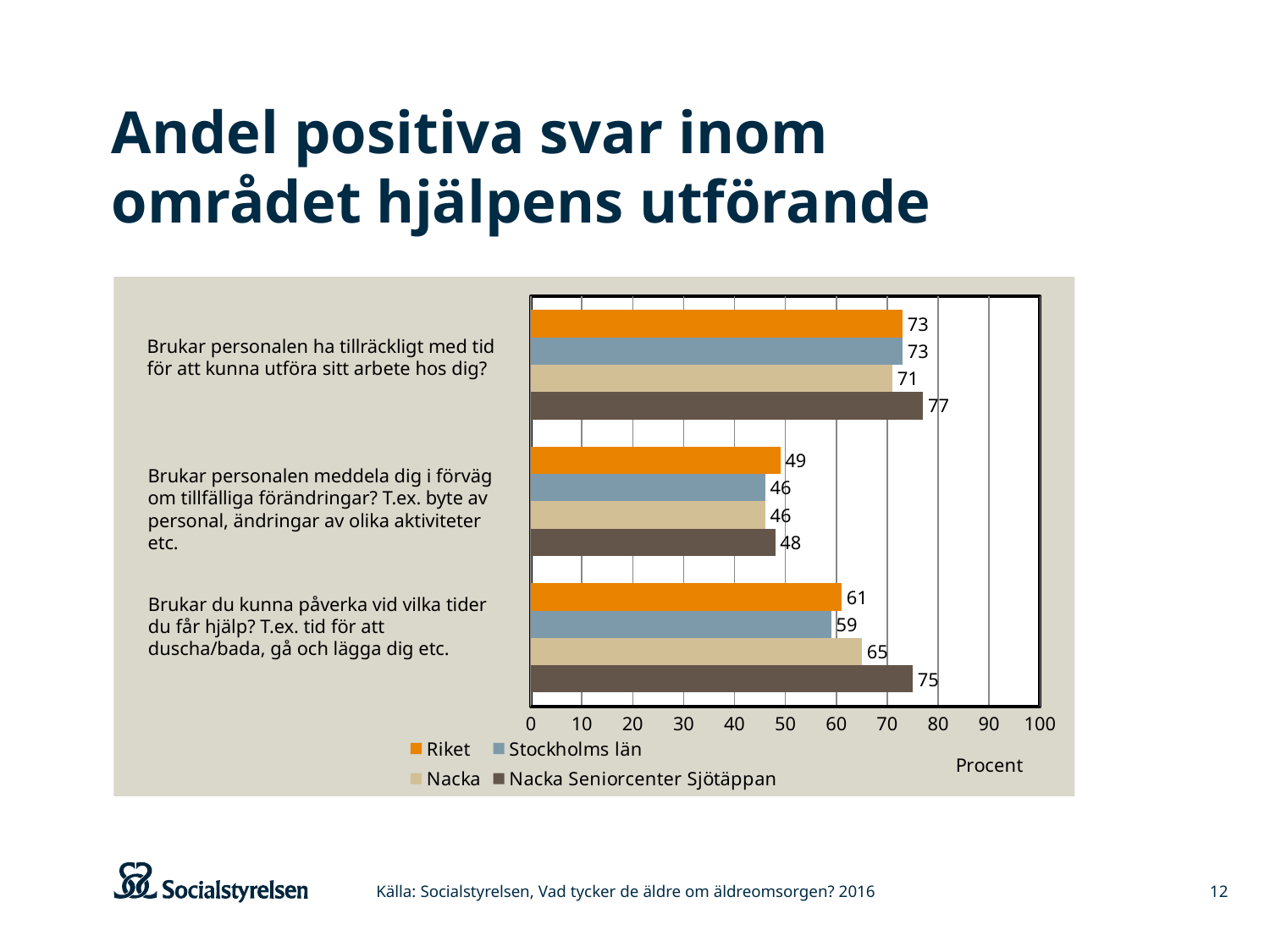
What is the value for Nacka on the question "Brukar du kunna påverka vid vilka tider du får hjälp?"? 65 How many questions (categories) are shown on the chart? 3 What is the value for Riket on the question "Brukar personalen ha tillräckligt med tid för att kunna utföra sitt arbete hos dig?"? 73 What kind of chart is shown on the slide? Bar chart Which is larger on the question "Brukar personalen meddela dig i förväg om tillfälliga förändringar?": Riket or Nacka Seniorcenter Sjötäppan? Riket What is the value for Stockholms län on the question "Brukar personalen meddela dig i förväg om tillfälliga förändringar?"? 46 What is the value for Nacka Seniorcenter Sjötäppan on the question "Brukar du kunna påverka vid vilka tider du får hjälp?"? 75 What is the difference between Nacka Seniorcenter Sjötäppan and Stockholms län on the question "Brukar du kunna påverka vid vilka tider du får hjälp?"? 16 How many series does the legend list? 4 Which series has the lowest value on the question "Brukar du kunna påverka vid vilka tider du får hjälp?"? Stockholms län What is the label on the horizontal axis of the chart? Procent Which series has the highest value on the question "Brukar personalen ha tillräckligt med tid för att kunna utföra sitt arbete hos dig?"? Nacka Seniorcenter Sjötäppan